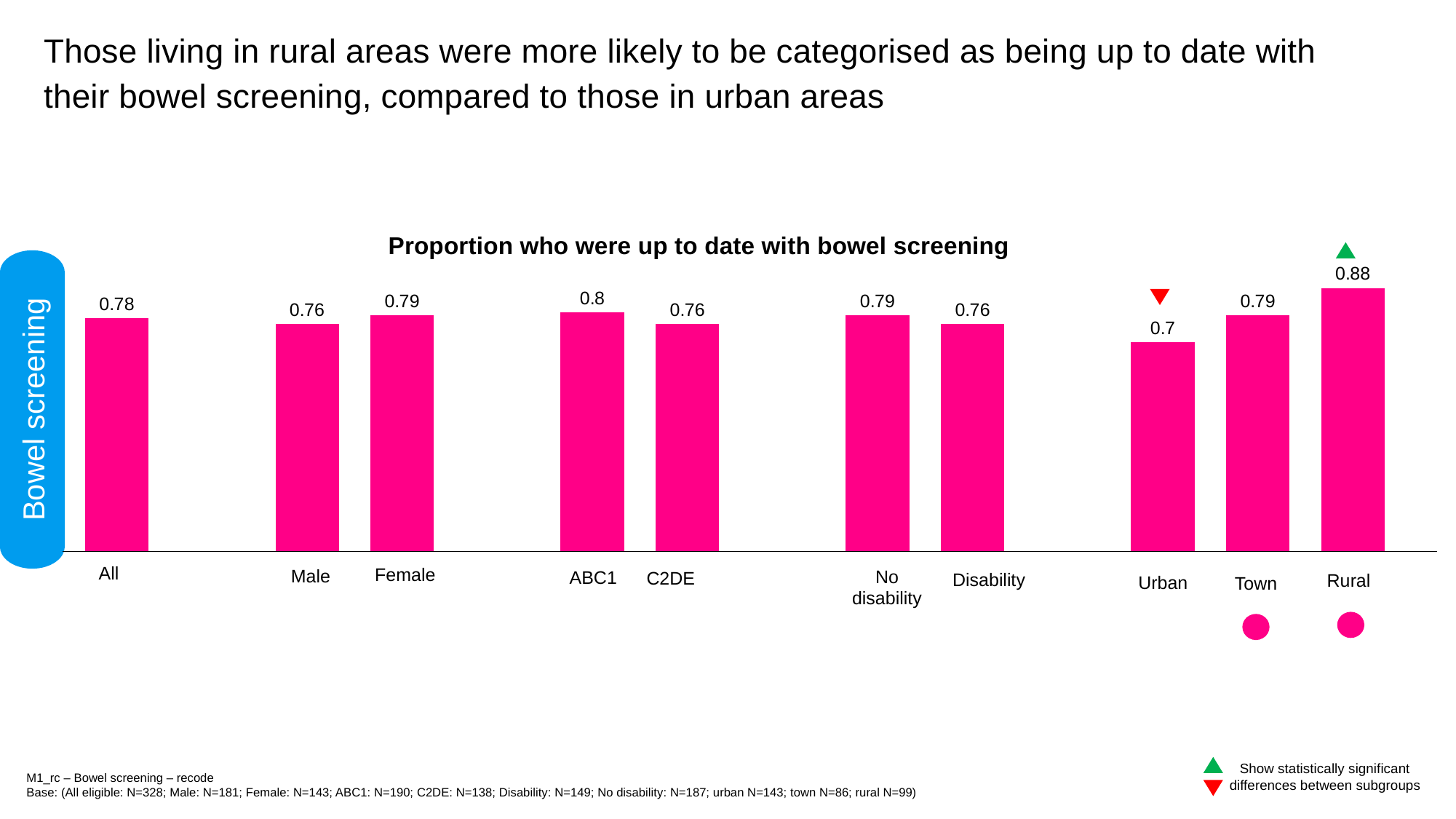
Which category has the highest value? Rural What is the value for Rural? 0.88 Which is larger, the value for No disability or the value for Disability? No disability Which category has the lowest value? Urban What kind of chart is shown on the slide? Bar chart What is the value for All? 0.78 How many categories are shown in the chart? 10 What is the difference between the values for Female and Male? 0.03 What is the value for ABC1? 0.8 What is the value for Urban? 0.7 What is the title of the chart? Proportion who were up to date with bowel screening What is the difference between the values for Rural and Urban? 0.18